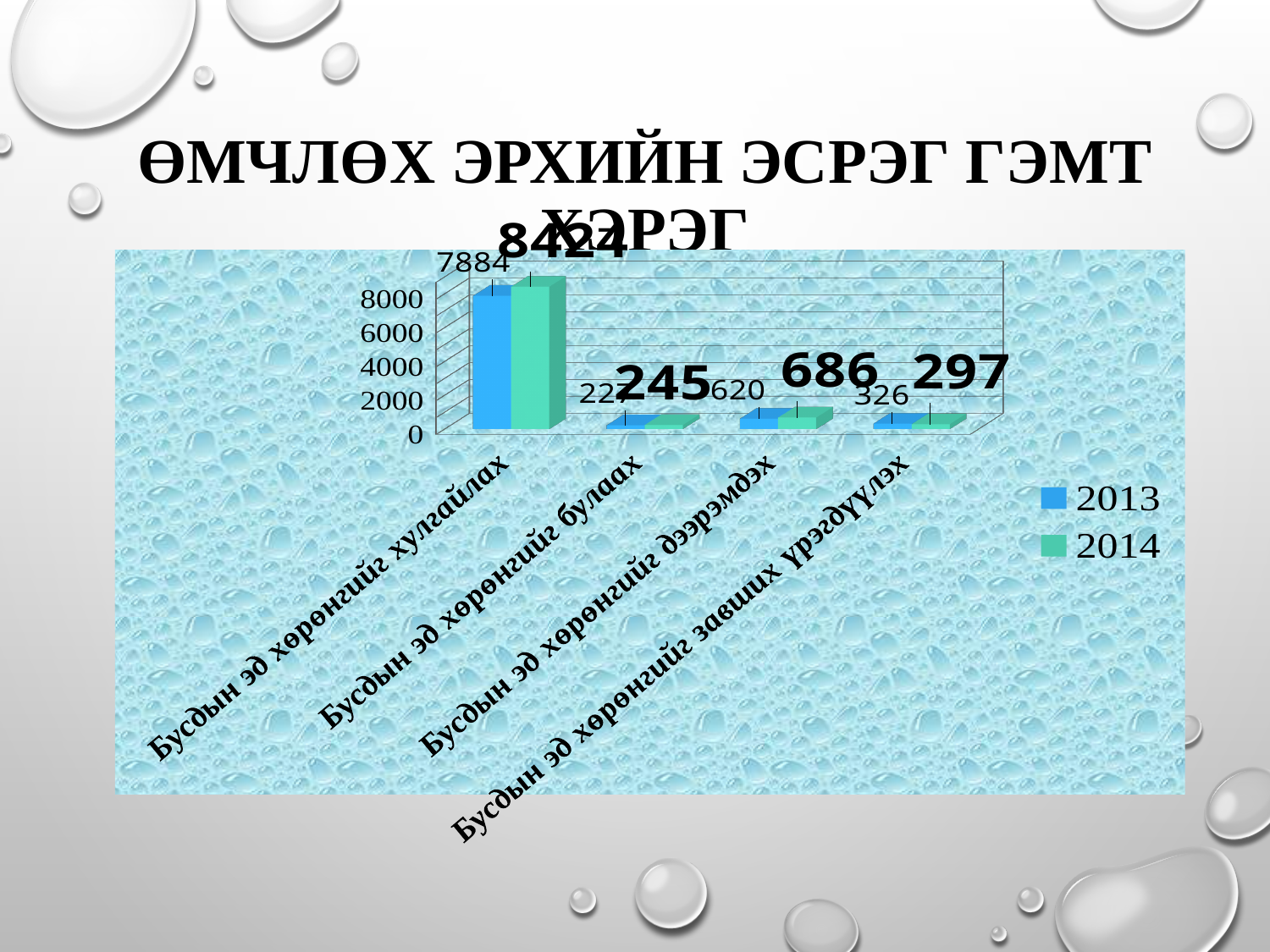
Which category has the highest value for 2014? Бусдын эд хөрөнгийг хулгайлах What is the value for 2014 in the category "Бусдын эд хөрөнгийг дээрэмдэх"? 686 What is the value for 2014 in the category "Бусдын эд хөрөнгийг хулгайлах"? 8424 What is the value for 2013 in the category "Бусдын эд хөрөнгийг завших үрэгдүүлэх"? 326 In the category "Бусдын эд хөрөнгийг завших үрэгдүүлэх", which year has the larger value, 2013 or 2014? 2013 What is the value for 2014 in the category "Бусдын эд хөрөнгийг булаах"? 245 How many categories are shown on the x axis? 4 What is the value for 2013 in the category "Бусдын эд хөрөнгийг дээрэмдэх"? 620 What is the difference between the 2014 and 2013 values for "Бусдын эд хөрөнгийг хулгайлах"? 540 How many series does the legend list? 2 What is the value for 2013 in the category "Бусдын эд хөрөнгийг хулгайлах"? 7884 What kind of chart is shown on the slide? Bar chart